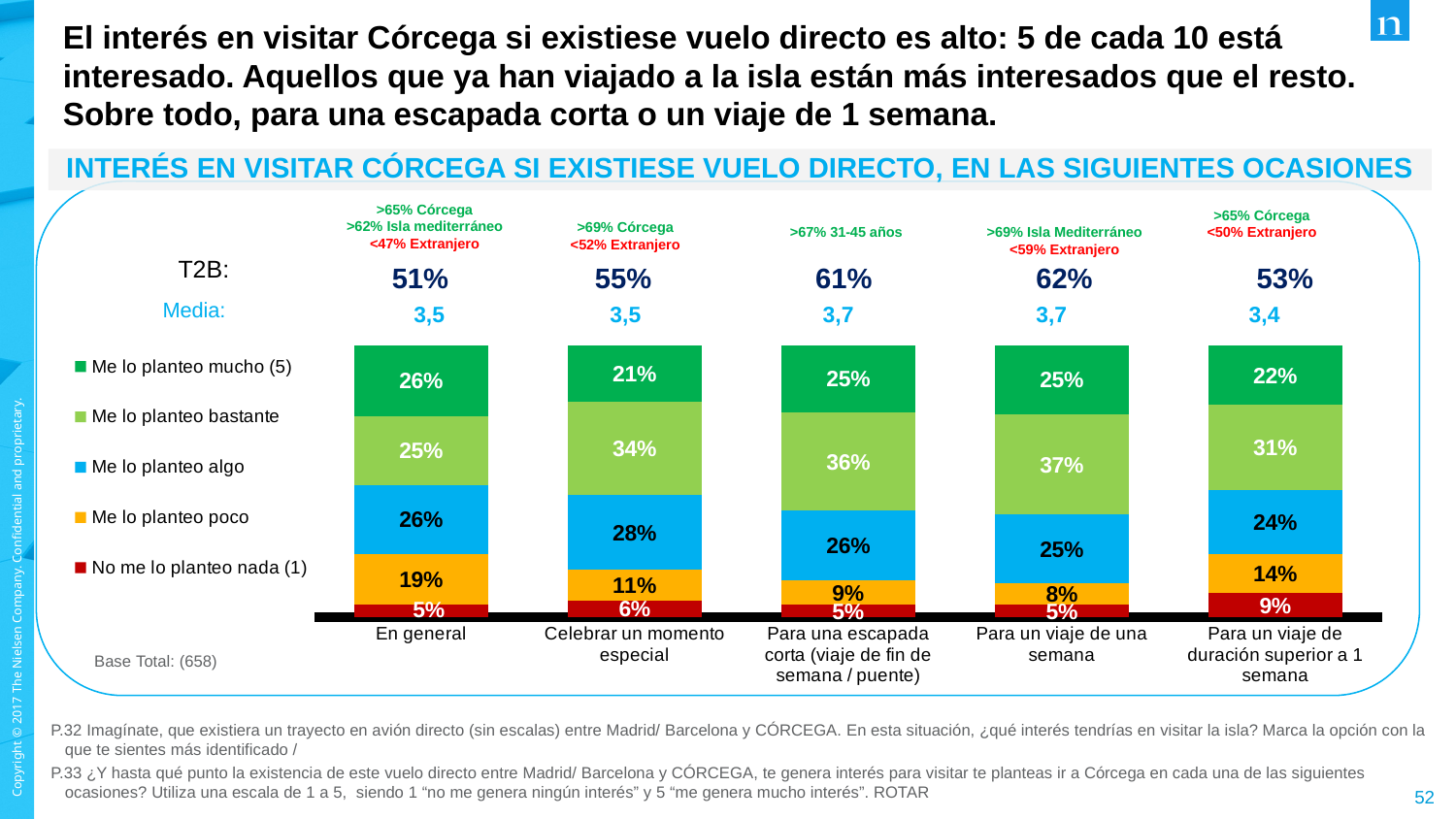
What is the value of "Me lo planteo bastante" for "Para un viaje de una semana"? 37% What is the T2B value shown for "Para una escapada corta (viaje de fin de semana / puente)"? 61% What percentage of respondents chose "Me lo planteo mucho (5)" for "En general"? 26% What kind of chart is shown on the slide? Stacked bar chart What is the "No me lo planteo nada (1)" value for "Para un viaje de duración superior a 1 semana"? 9% How many series does the legend list? 5 What is the difference between the "Me lo planteo poco" values for "En general" and "Celebrar un momento especial"? 8% How many categories (occasions) are shown on the x axis of the chart? 5 Which category has the lowest "Me lo planteo poco" value? Para un viaje de una semana Which category has the highest "Me lo planteo bastante" value? Para un viaje de una semana What is the total of the stacked bar for "Celebrar un momento especial"? 100% Which is larger: "Me lo planteo mucho (5)" for "En general" or for "Celebrar un momento especial"? En general